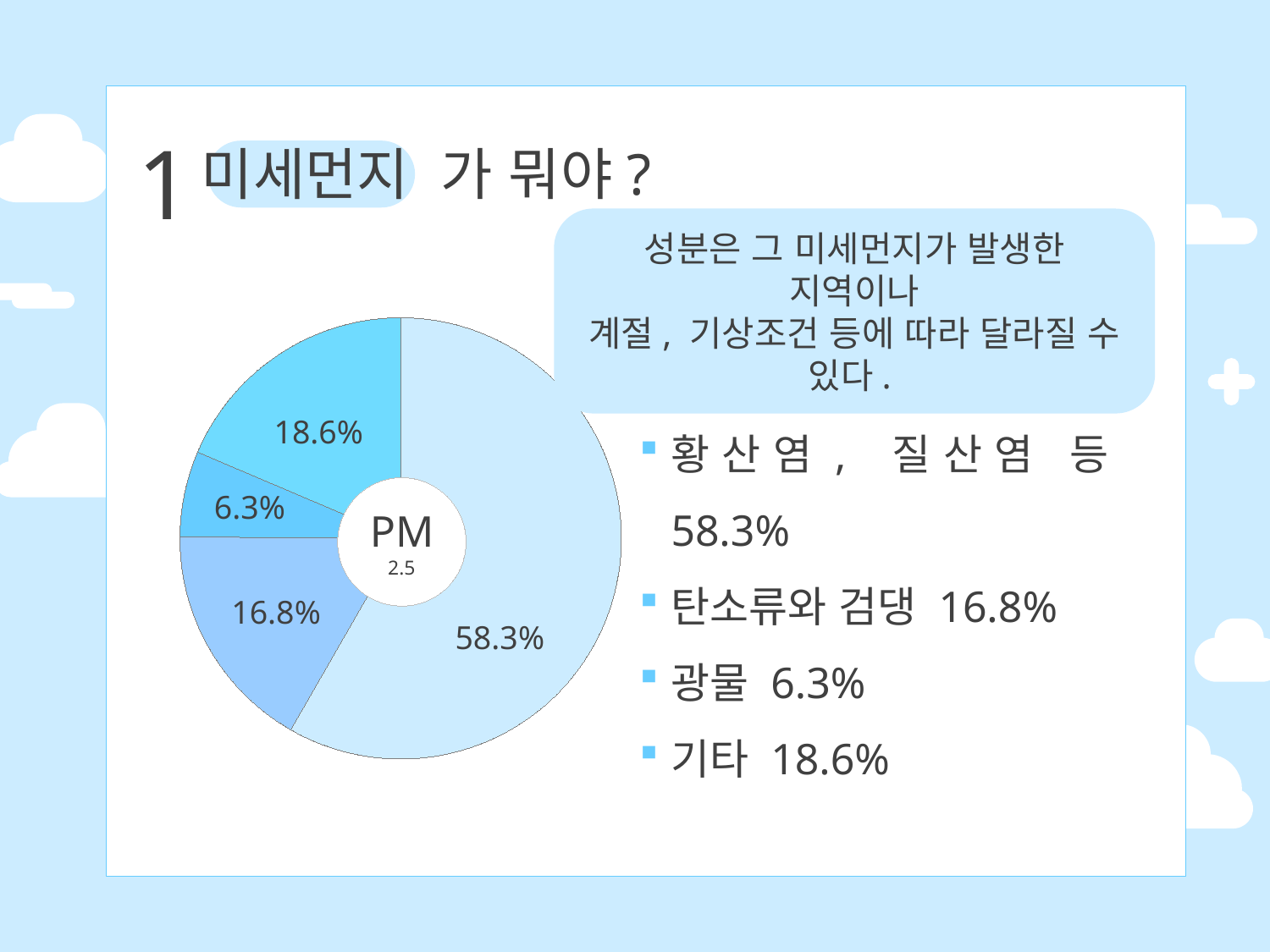
What share of the PM2.5 pie chart is labelled for 황산염, 질산염 등? 58.3% Which is larger in the pie chart: the share for 기타 or the share for 탄소류와 검댕? 기타 What is the smallest share shown in the PM2.5 pie chart? 6.3% What is the largest share shown in the PM2.5 pie chart? 58.3% What text is written in the centre of the pie chart? PM 2.5 How many slices does the PM2.5 pie chart have? 4 What kind of chart is shown on the slide? pie chart What share of the PM2.5 pie chart corresponds to 광물? 6.3% What share of the PM2.5 pie chart corresponds to 탄소류와 검댕? 16.8% What is the difference between the shares for 탄소류와 검댕 and 광물 in the pie chart? 10.5% What is the difference between the 58.3% slice and the 18.6% slice in the pie chart? 39.7%